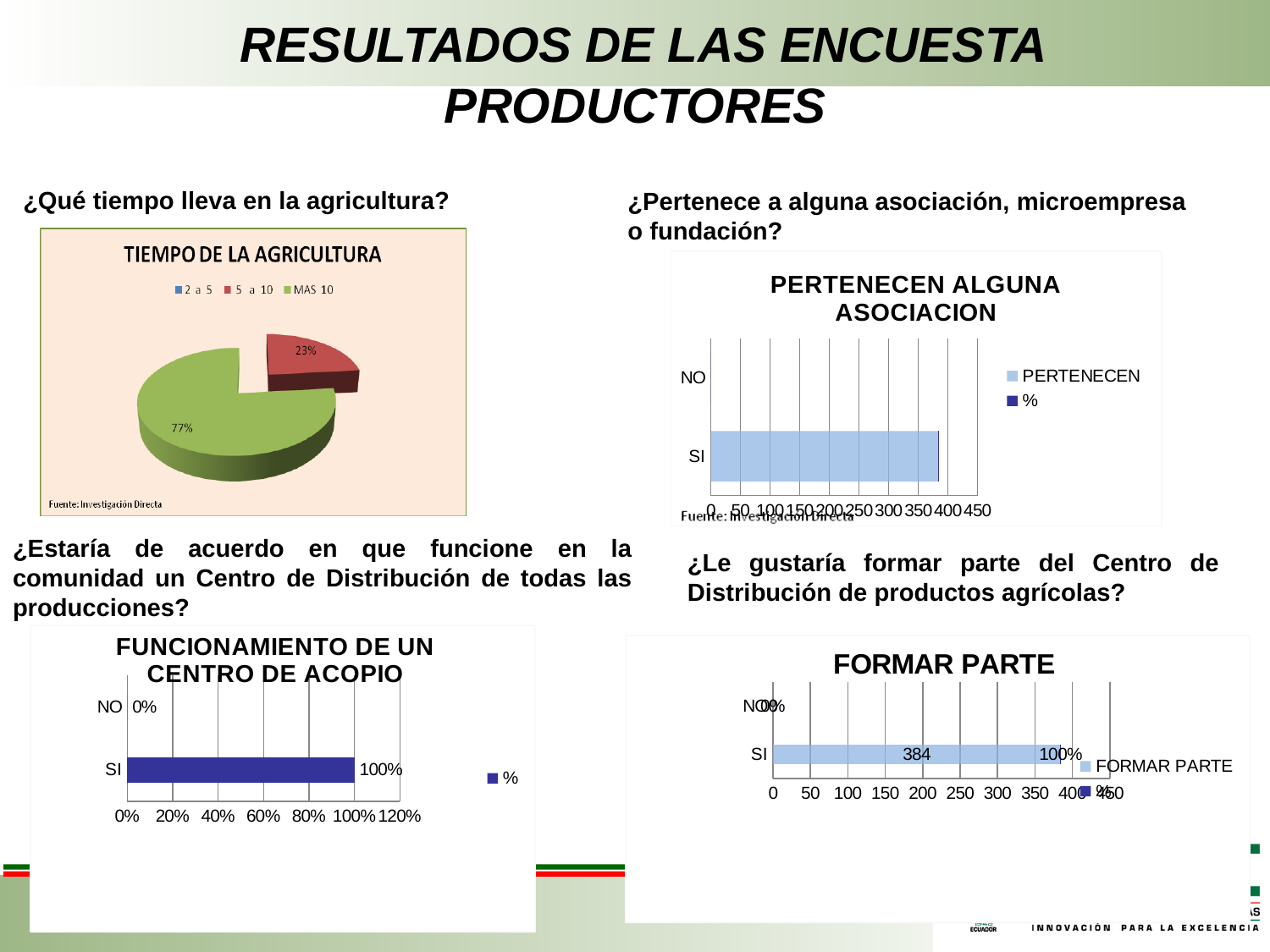
In the TIEMPO DE LA AGRICULTURA chart, what percentage is shown for the 5 a 10 slice? 23% In the PERTENECEN ALGUNA ASOCIACION chart, which category has the larger bar, SI or NO? SI In the TIEMPO DE LA AGRICULTURA chart, what percentage is shown for the MAS 10 slice? 77% In the FORMAR PARTE chart, what is the % value for SI? 100% In the TIEMPO DE LA AGRICULTURA chart, which category has the largest slice? MAS 10 How many entries does the legend of the TIEMPO DE LA AGRICULTURA chart list? 3 In the FORMAR PARTE chart, what is the FORMAR PARTE value for SI? 384 In the FUNCIONAMIENTO DE UN CENTRO DE ACOPIO chart, what is the value for SI? 100% What kind of chart is PERTENECEN ALGUNA ASOCIACION? Bar chart In the PERTENECEN ALGUNA ASOCIACION chart, is the value for SI greater or less than 350? greater In the FUNCIONAMIENTO DE UN CENTRO DE ACOPIO chart, what is the value for NO? 0% What kind of chart is TIEMPO DE LA AGRICULTURA? Pie chart